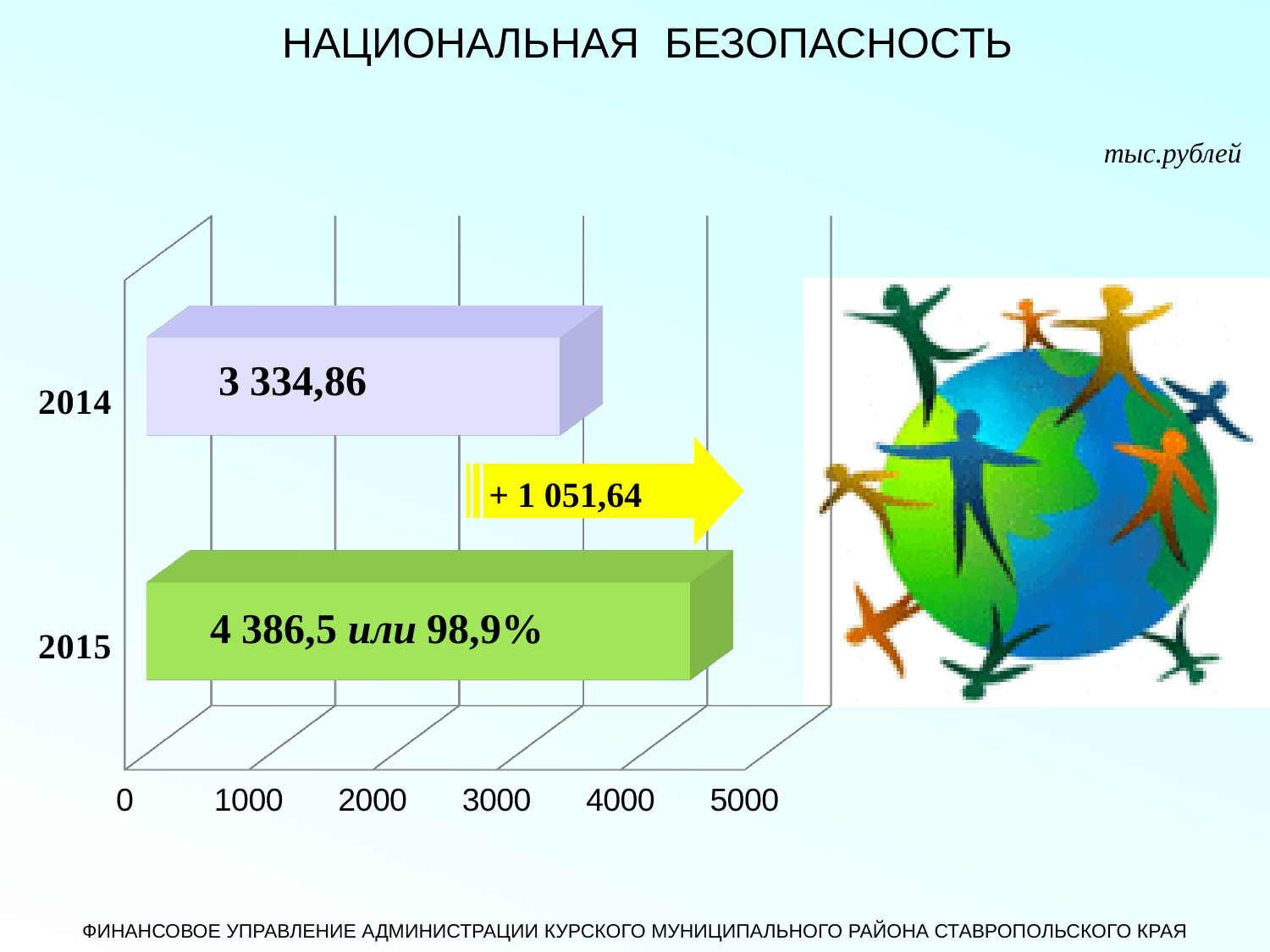
How many years are shown in the chart? 2 What is the value for 2014? 3 334,86 Which year has the higher value? 2015 Which year has the lower value? 2014 What is the value for 2015? 4 386,5 By how much does the 2015 value exceed the 2014 value? 1 051,64 In what units are the chart values given? тыс.рублей Is the value for 2015 greater or less than 4000? greater Is the value for 2014 larger or smaller than the value for 2015? smaller What percentage is shown next to the 2015 value? 98,9% Is the value for 2014 greater or less than 4000? less What kind of chart is shown on the slide? bar chart